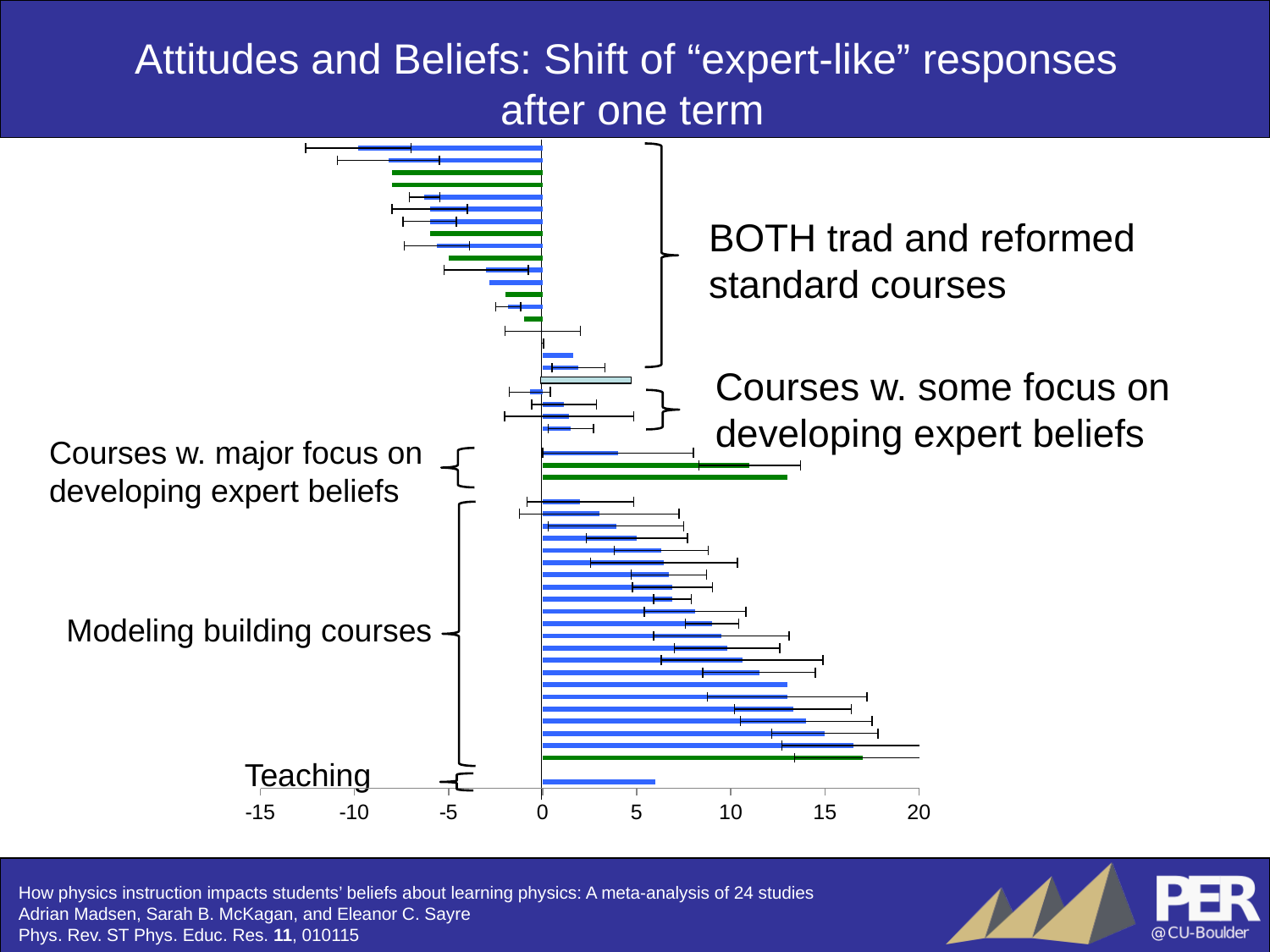
What is the lowest value shown on the horizontal axis? -15 Is the longest bar in the Courses w. major focus on developing expert beliefs group greater or less than 10? greater What kind of chart is shown on the slide? bar chart Is the longest bar in the Modeling building courses group greater or less than 15? greater Which labeled group of courses has bars that are mostly negative (extending left of 0)? BOTH trad and reformed standard courses Which labeled group of courses contains the longest bar on the chart? Modeling building courses Is the value for the Teaching bar greater or less than 10? less Is the longest bar in the Modeling building courses group larger than the Teaching bar? Yes What is the title of the slide's chart? Attitudes and Beliefs: Shift of "expert-like" responses after one term How many labeled groups of courses are marked with brackets on the chart? 5